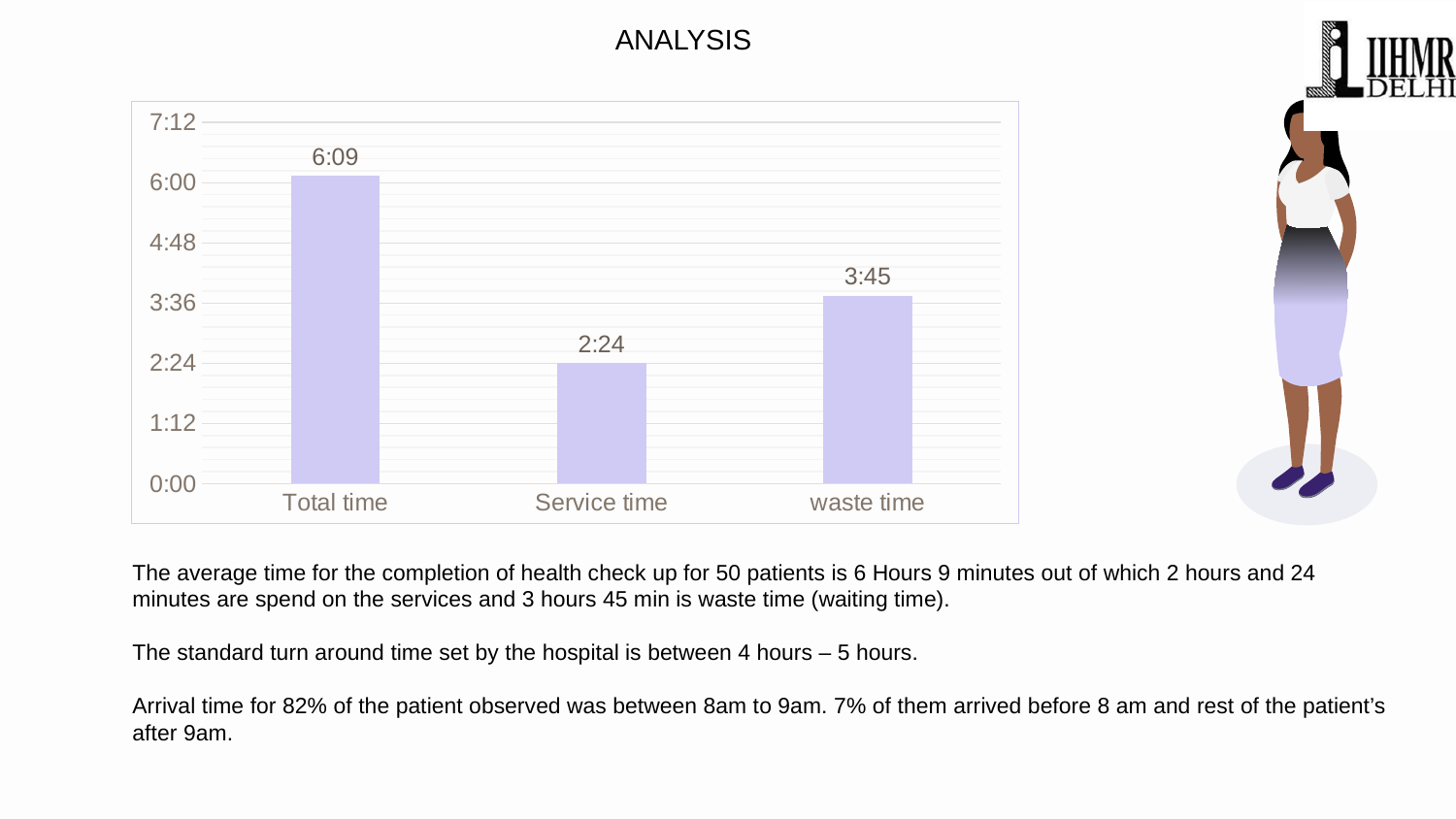
What is the difference between the waste time and the Service time values? 1:21 What is the value shown for Total time? 6:09 Which category has the lowest value? Service time What is the value shown for Service time? 2:24 What is the highest tick label shown on the y axis of the chart? 7:12 What kind of chart is shown on the slide? Bar chart What is the difference between the Total time and the Service time values? 3:45 Which is larger, the value for waste time or the value for Service time? waste time Is the value for waste time greater or less than 3:36? greater How many categories are shown on the x axis of the chart? 3 What is the value shown for waste time? 3:45 Which category has the highest value? Total time